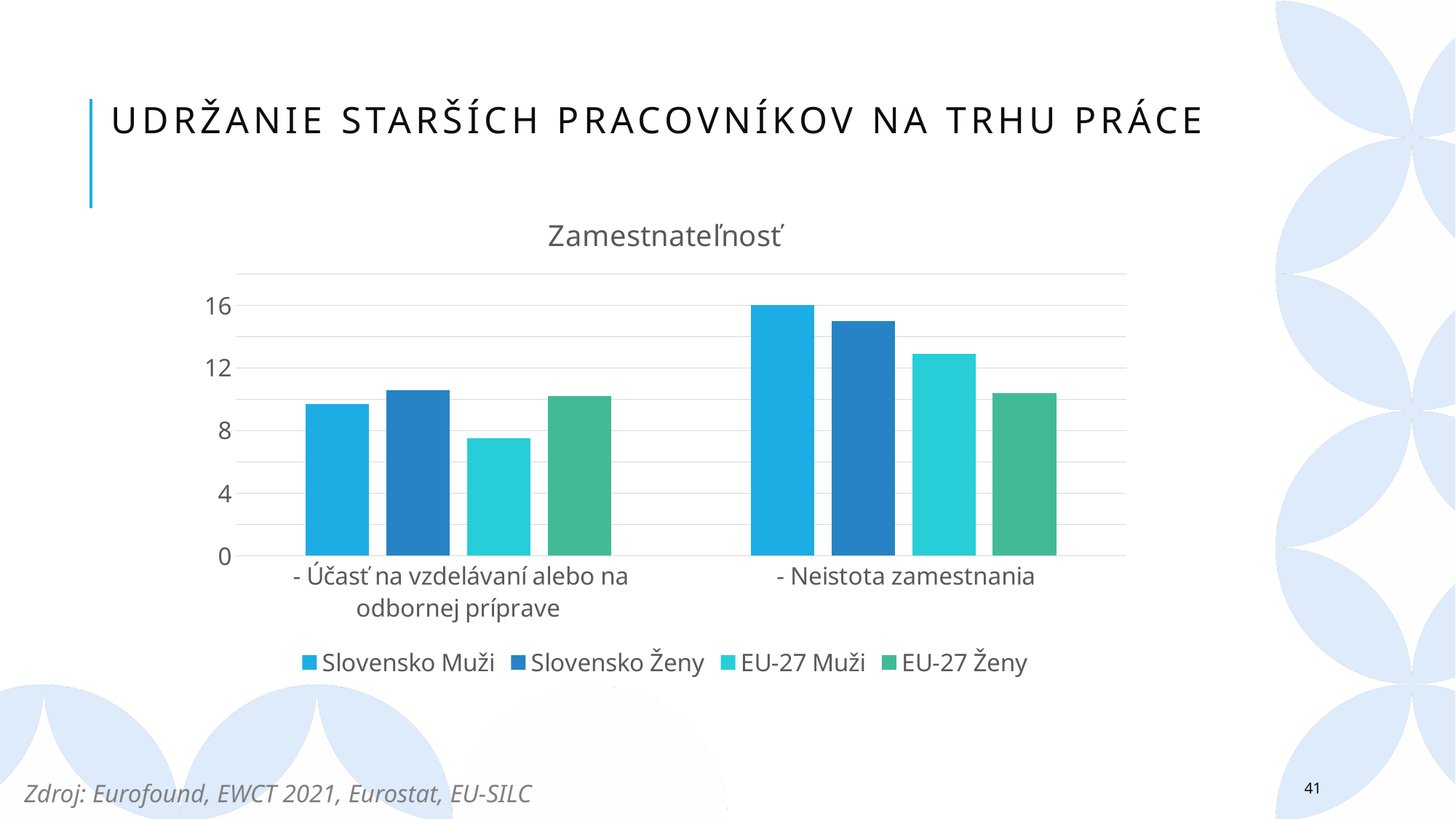
Which series has the highest value for '- Neistota zamestnania'? Slovensko Muži What is the title of the chart? Zamestnateľnosť Which series has the lowest value for '- Neistota zamestnania'? EU-27 Ženy Which series has the lowest value for '- Účasť na vzdelávaní alebo na odbornej príprave'? EU-27 Muži How many series does the legend list? 4 Which is larger: Slovensko Ženy in '- Neistota zamestnania' or EU-27 Muži in '- Neistota zamestnania'? Slovensko Ženy Is the value for EU-27 Ženy in '- Neistota zamestnania' greater or less than 12? less How many categories are shown on the x axis? 2 Is the value for Slovensko Muži in '- Neistota zamestnania' greater or less than 12? greater What kind of chart is shown on the slide? bar chart Which is larger: Slovensko Muži in '- Účasť na vzdelávaní alebo na odbornej príprave' or EU-27 Muži in the same category? Slovensko Muži Is the value for EU-27 Muži in '- Účasť na vzdelávaní alebo na odbornej príprave' greater or less than 8? less